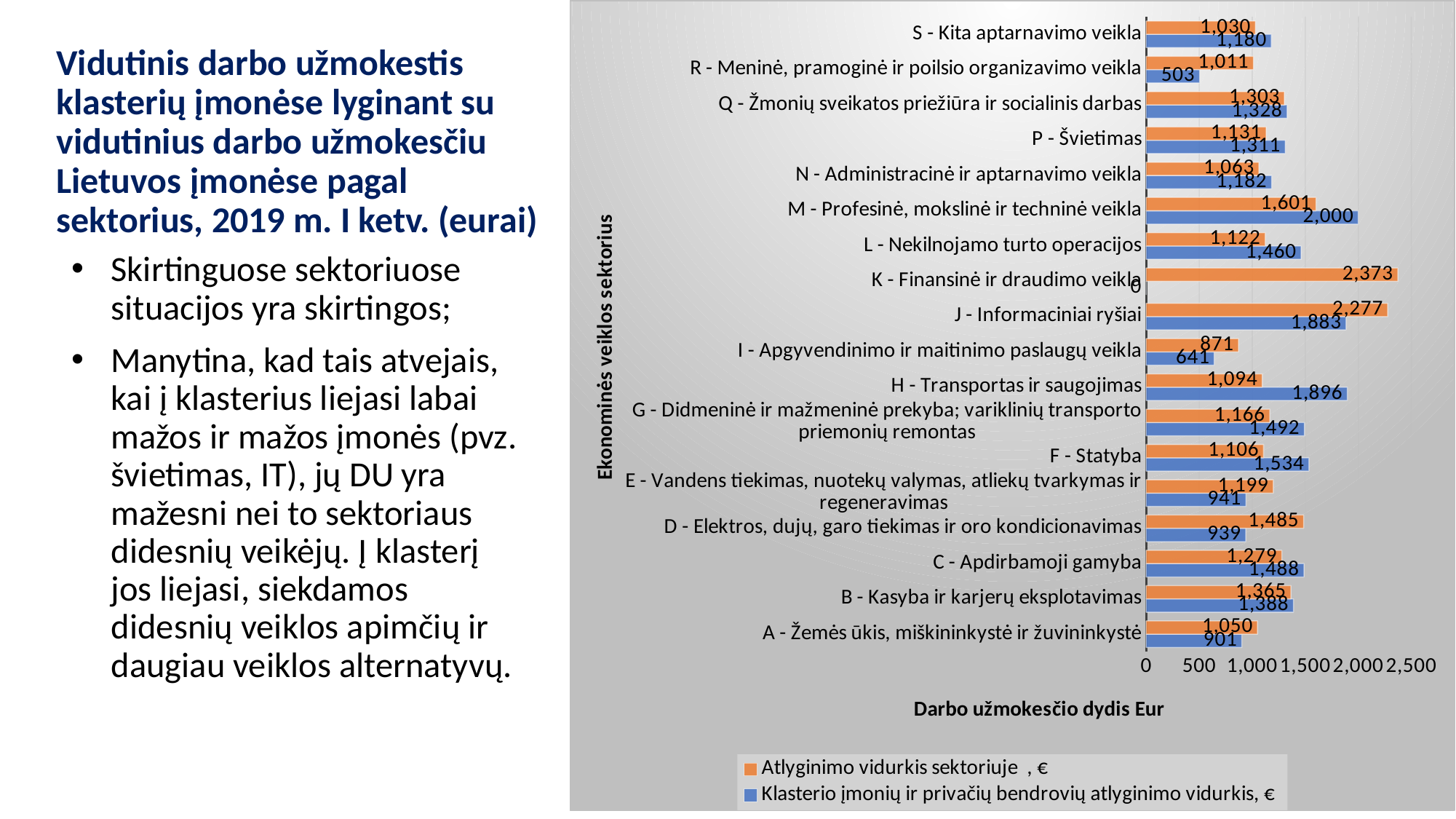
How many series does the legend list? 2 Which sector has the lowest value for 'Atlyginimo vidurkis sektoriuje, €'? I - Apgyvendinimo ir maitinimo paslaugų veikla What is the x-axis title of the chart? Darbo užmokesčio dydis Eur What is the difference between 'Atlyginimo vidurkis sektoriuje, €' and 'Klasterio įmonių ir privačių bendrovių atlyginimo vidurkis, €' for 'J - Informaciniai ryšiai'? 394 Which sector has the highest value for 'Atlyginimo vidurkis sektoriuje, €'? K - Finansinė ir draudimo veikla What type of chart is shown on the slide? bar chart What is the value of 'Klasterio įmonių ir privačių bendrovių atlyginimo vidurkis, €' for 'M - Profesinė, mokslinė ir techninė veikla'? 2,000 For 'D - Elektros, dujų, garo tiekimas ir oro kondicionavimas', which series has the larger value? Atlyginimo vidurkis sektoriuje, € What is the value of 'Atlyginimo vidurkis sektoriuje, €' for 'K - Finansinė ir draudimo veikla'? 2,373 How many economic sectors (categories) are plotted on the chart? 18 What is the value of 'Klasterio įmonių ir privačių bendrovių atlyginimo vidurkis, €' for 'R - Meninė, pramoginė ir poilsio organizavimo veikla'? 503 What is the difference between the two series for 'H - Transportas ir saugojimas'? 802